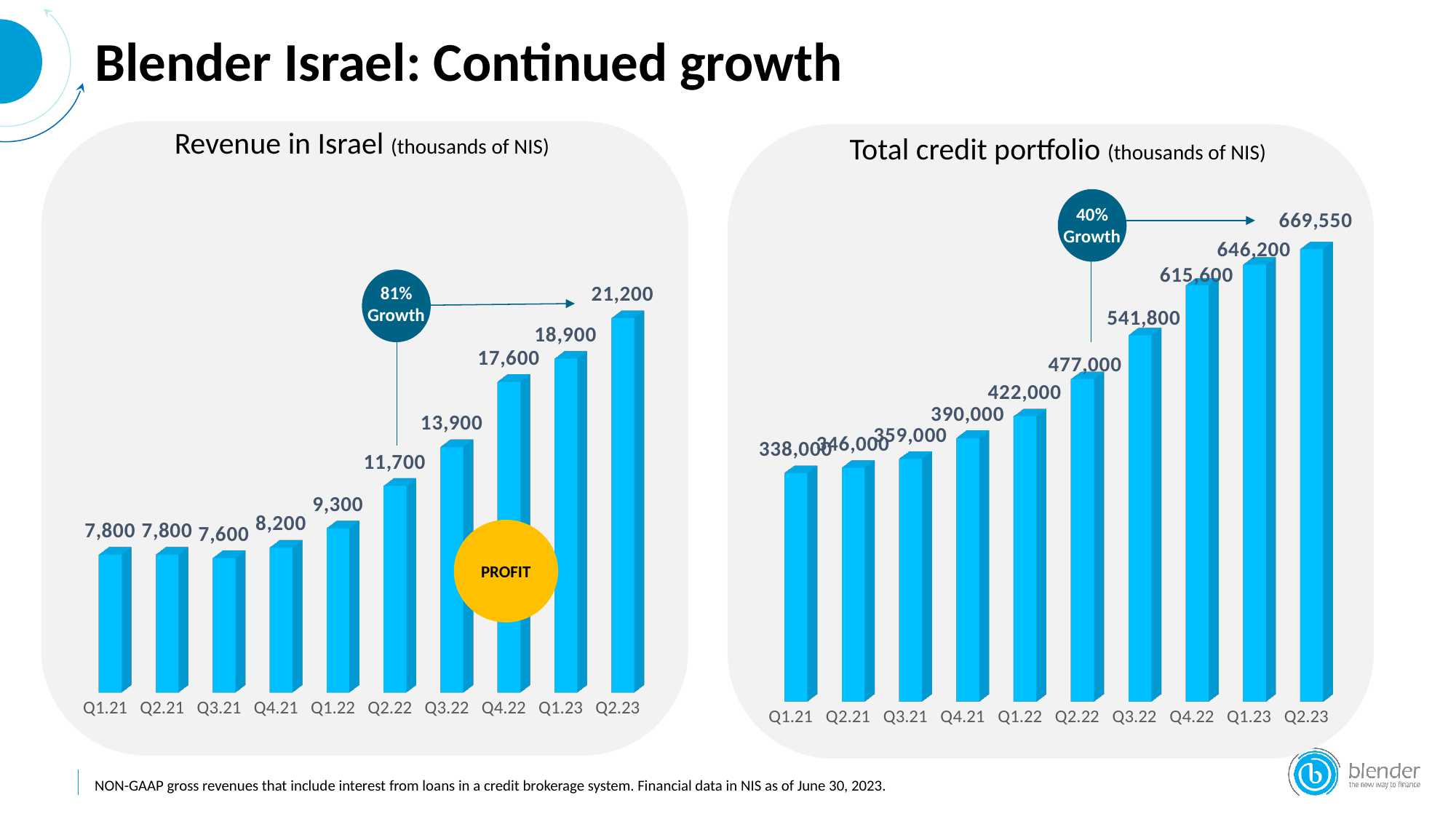
In the Revenue in Israel chart, do the values generally rise or fall from Q1.22 to Q2.23? rise In the Revenue in Israel chart, which quarter has the lowest value? Q3.21 In the Revenue in Israel chart, what is the value for Q2.22? 11,700 In the Total credit portfolio chart, what is the difference between Q4.22 and Q3.22? 73,800 In the Revenue in Israel chart, what is the value for Q2.23? 21,200 What type of chart is the Total credit portfolio chart? bar chart In the Revenue in Israel chart, how many quarters are shown on the x axis? 10 In the Total credit portfolio chart, which is larger, the value for Q1.22 or the value for Q2.22? Q2.22 In the Total credit portfolio chart, which quarter has the highest value? Q2.23 In the Revenue in Israel chart, what is the difference between Q2.23 and Q1.23? 2,300 In the Total credit portfolio chart, what is the value for Q2.23? 669,550 In the Total credit portfolio chart, what is the value for Q4.21? 390,000